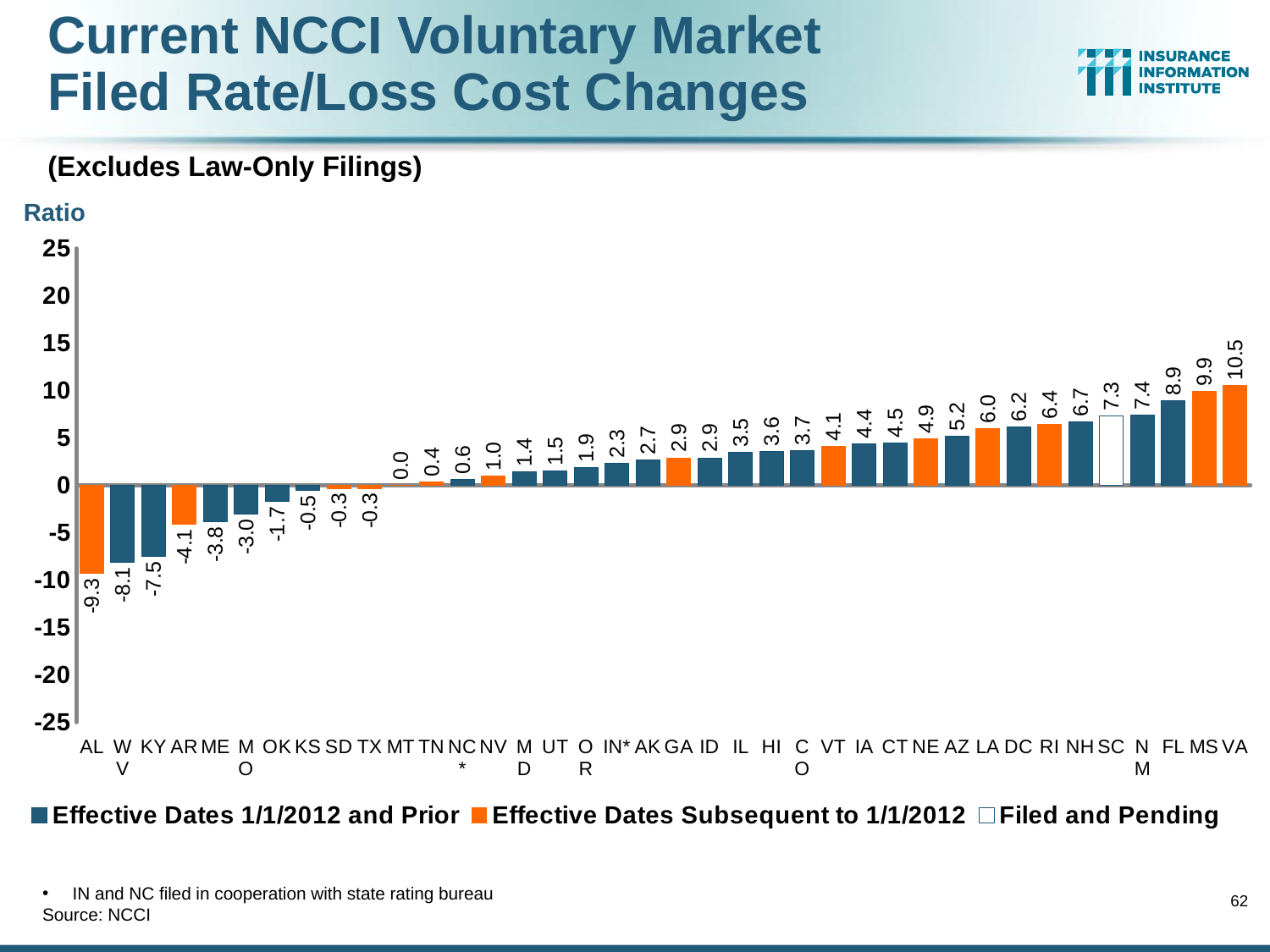
What is the value for AL? -9.3 What is the value for SC? 7.3 Which is larger, the value for FL or the value for NH? FL What kind of chart is shown? Bar chart Which state has the lowest value? AL Which state has the highest value? VA What is the value for MT? 0.0 Which legend entry does the white (unfilled) bar for SC represent? Filed and Pending What is the difference between the values for AL and WV? 1.2 What is the difference between the values for VA and MS? 0.6 What is the value for VA? 10.5 How many series does the legend list? 3